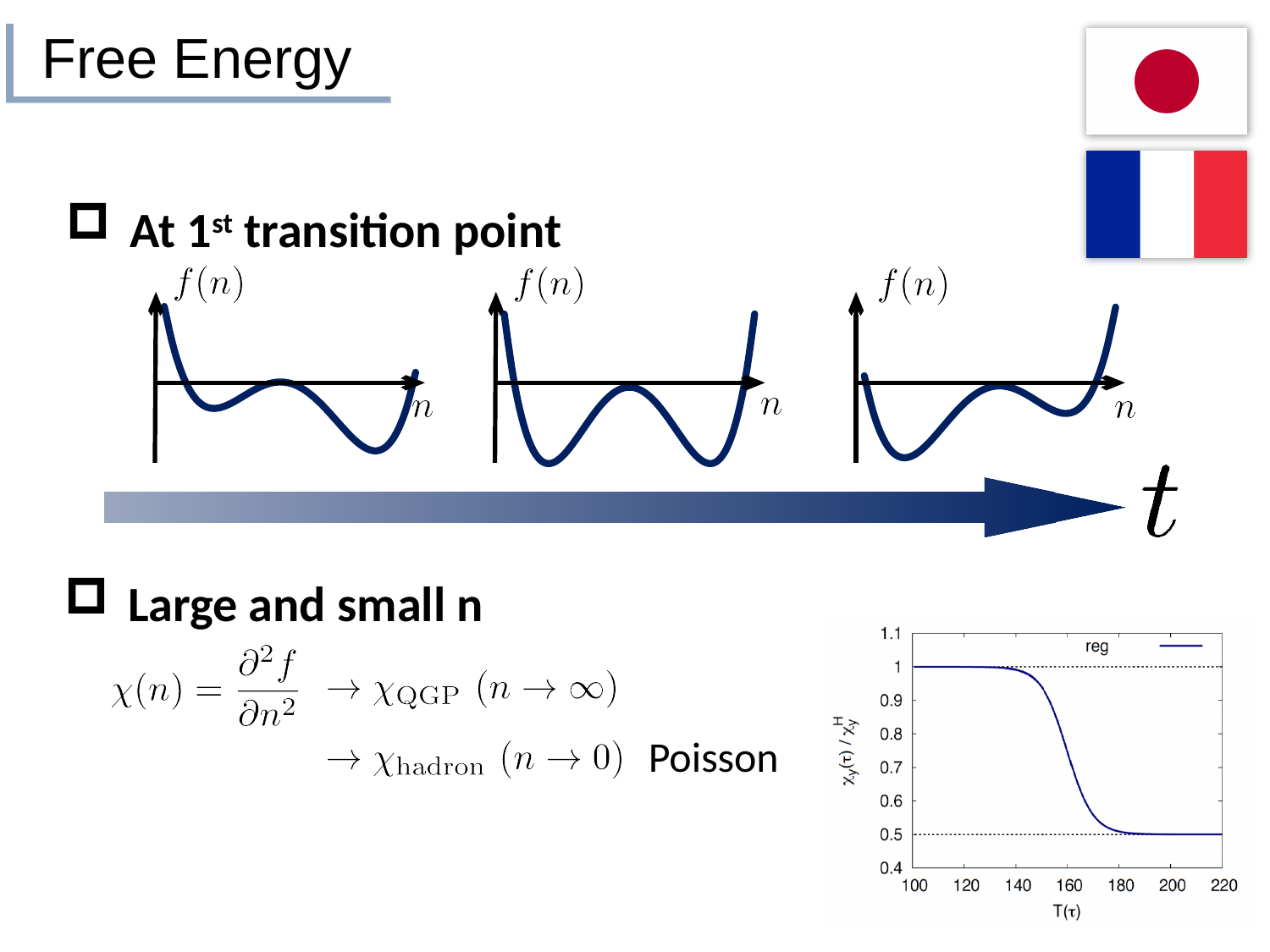
In the bottom-right chart, is the value of the curve at T(τ) = 140 greater or less than 0.8? greater In the bottom-right chart, is the value of the curve at T(τ) = 120 greater or less than 0.9? greater In the bottom-right chart, what is the label of the x axis? T(τ) In the bottom-right chart, how many series does the legend list? 1 In the bottom-right chart, what is the name of the series in the legend? reg In the bottom-right chart, does the plotted curve rise or fall as T(τ) increases from 100 to 220? fall In the bottom-right chart, what value does the curve plateau at for high T(τ), around 220? 0.5 What kind of chart is shown at the bottom right of the slide? line chart In the bottom-right chart, is the value of the curve at T(τ) = 180 greater or less than 0.7? less In the bottom-right chart, what value does the curve plateau at for low T(τ), around 100? 1 In the bottom-right chart, which is larger: the value of the curve at T(τ) = 120 or at T(τ) = 200? T(τ) = 120